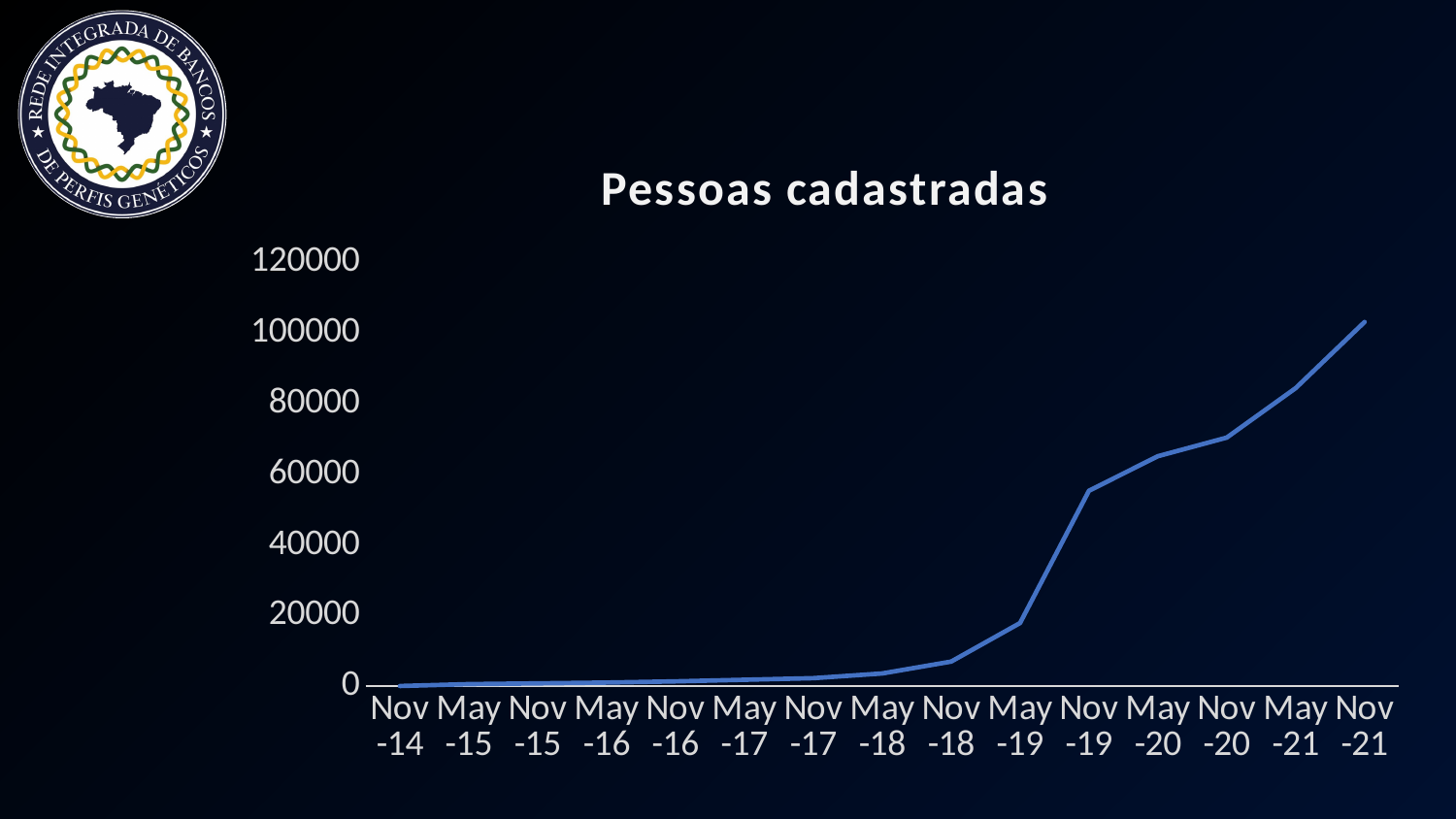
Is the value for Nov-20 greater or less than 60000? greater What is the title of the chart? Pessoas cadastradas Do the values in the chart rise or fall from Nov-14 to Nov-21? rise What type of chart is shown on the slide? line chart Is the value for May-19 greater or less than 20000? less How many points are plotted along the x axis of the chart? 15 Which has the larger value, May-18 or May-20? May-20 Which has the larger value, Nov-19 or Nov-21? Nov-21 Is the value for Nov-21 greater or less than 80000? greater Which point on the x axis has the highest value? Nov-21